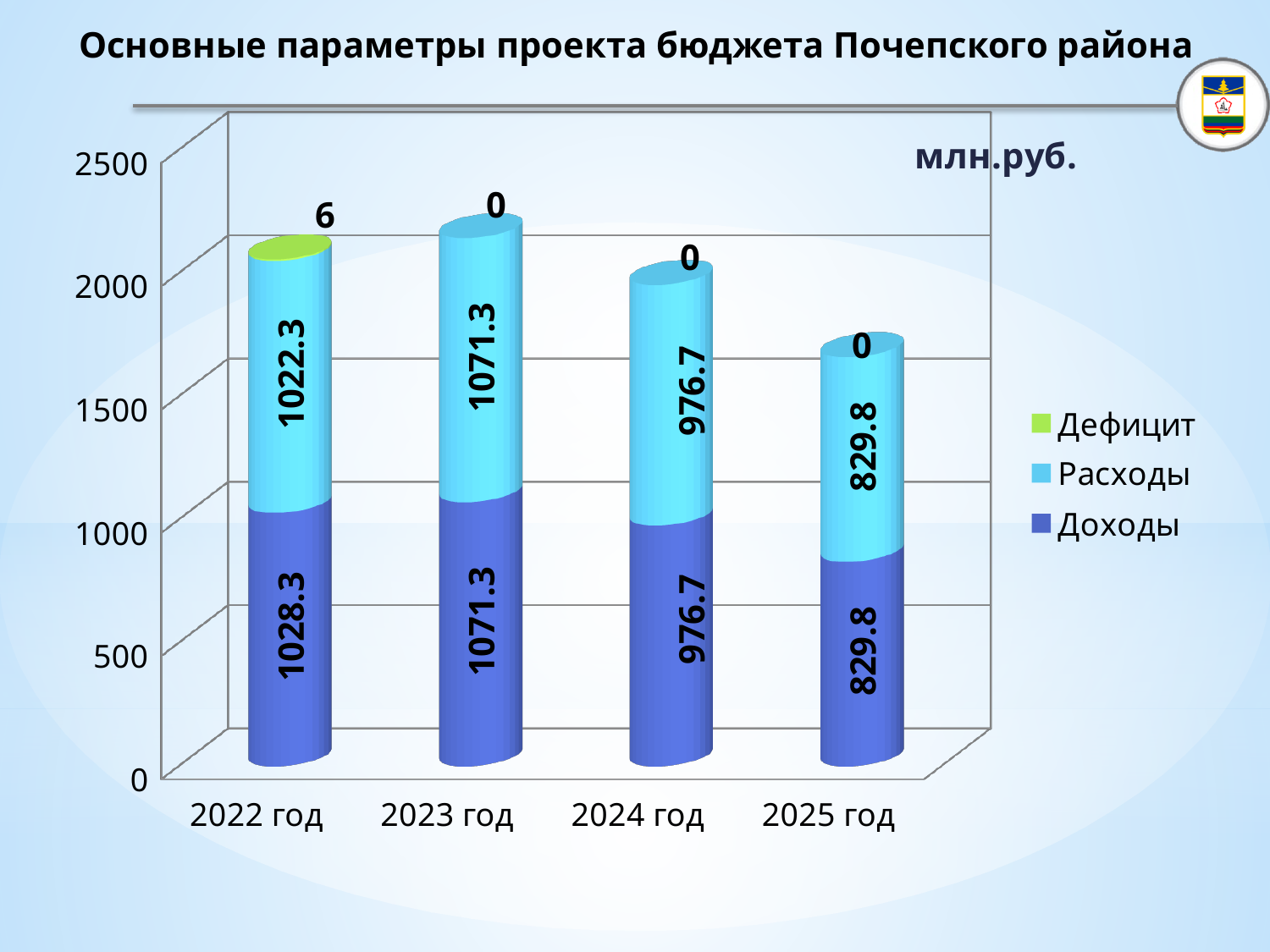
What kind of chart is shown on the slide? Stacked bar chart What is the difference between Доходы in 2023 год and Доходы in 2025 год? 241.5 What is the total of the stacked bar for 2023 год? 2142.6 Which year has the lowest value of Расходы? 2025 год Which year has the highest value of Доходы? 2023 год What is the value of Расходы for 2024 год? 976.7 How many years are shown on the x axis? 4 What is the value of Доходы for 2022 год? 1028.3 How many series does the legend list? 3 What is the value of Расходы for 2025 год? 829.8 Which is larger: Доходы in 2022 год or Расходы in 2022 год? Доходы in 2022 год What is the value of Дефицит for 2022 год? 6